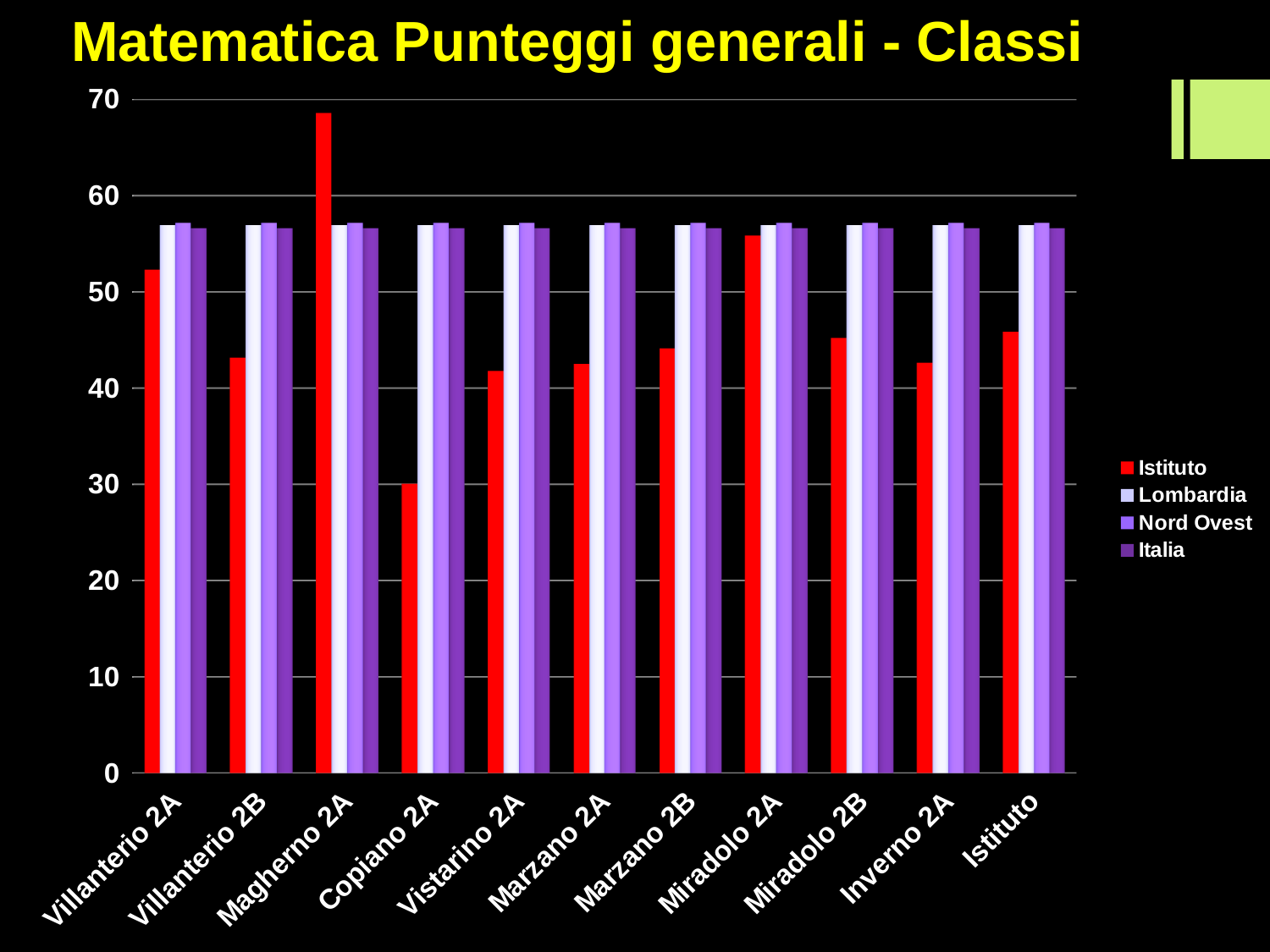
Is the Istituto value for Magherno 2A greater or less than 60? greater What is the title of the chart? Matematica Punteggi generali - Classi Which category has the lowest Istituto value? Copiano 2A Is the Istituto value for Copiano 2A greater or less than 40? less What kind of chart is shown on the slide? bar chart Which category has the highest Istituto value? Magherno 2A What colour represents the Istituto series in the chart? red Which has the larger Istituto value, Miradolo 2A or Miradolo 2B? Miradolo 2A Which has the larger Istituto value, Villanterio 2A or Villanterio 2B? Villanterio 2A How many categories are shown along the x axis of the chart? 11 Is the Istituto value for Miradolo 2A greater or less than 50? greater How many series does the legend list? 4